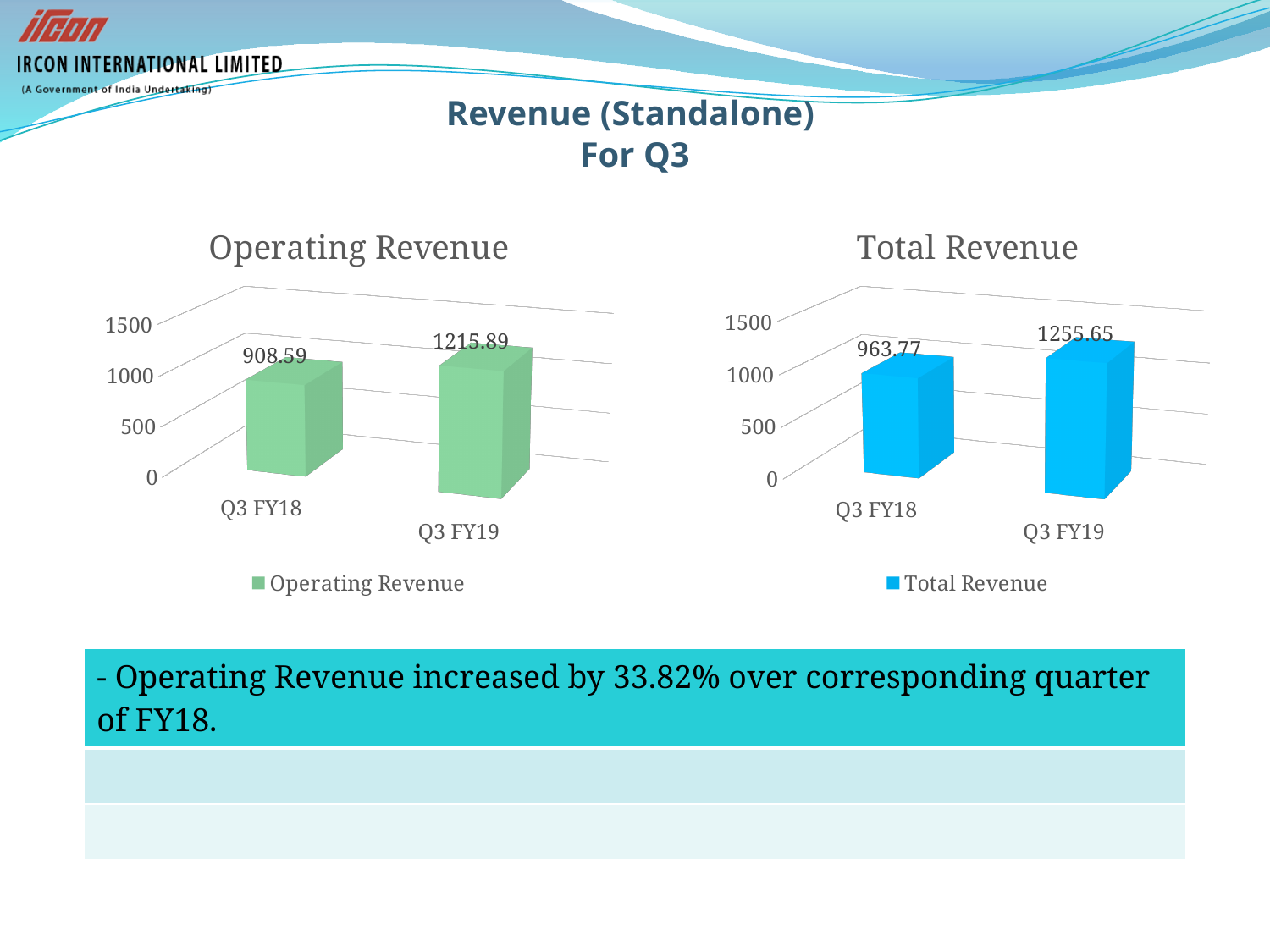
In the Operating Revenue chart, which quarter has the higher value? Q3 FY19 What type of chart is the Total Revenue chart? bar chart Is the Q3 FY18 value in the Total Revenue chart larger or smaller than the Q3 FY18 value in the Operating Revenue chart? larger How many categories are shown in the Operating Revenue chart? 2 In the Operating Revenue chart, what is the value for Q3 FY19? 1215.89 In the Operating Revenue chart, what is the difference between the Q3 FY19 and Q3 FY18 values? 307.30 In the Total Revenue chart, what is the value for Q3 FY18? 963.77 In the Total Revenue chart, what is the value for Q3 FY19? 1255.65 In the Total Revenue chart, do the values rise or fall from Q3 FY18 to Q3 FY19? rise In the Operating Revenue chart, what is the value for Q3 FY18? 908.59 In the Total Revenue chart, what is the difference between the Q3 FY19 and Q3 FY18 values? 291.88 In the Total Revenue chart, which quarter has the lower value? Q3 FY18